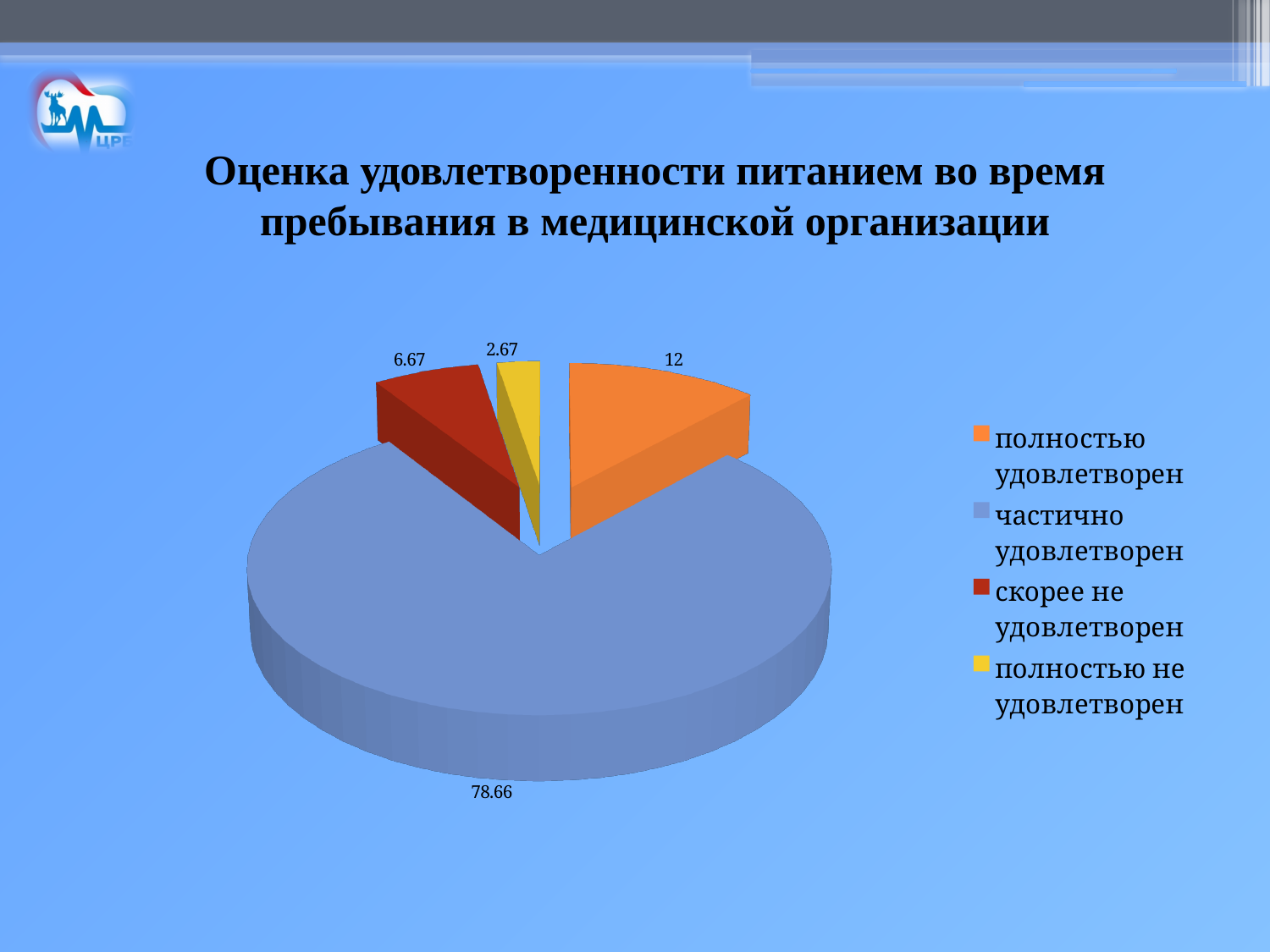
What is the value for "полностью удовлетворен"? 12 Which category has the largest slice? частично удовлетворен How many slices does the pie chart have? 4 What is the value for "полностью не удовлетворен"? 2.67 How many entries does the legend list? 4 What kind of chart is shown on the slide? pie chart What colour is the slice for "частично удовлетворен"? blue Which category has the smallest slice? полностью не удовлетворен What is the value for "частично удовлетворен"? 78.66 What is the value for "скорее не удовлетворен"? 6.67 What is the difference between the values for "полностью удовлетворен" and "скорее не удовлетворен"? 5.33 Which is larger, the value for "полностью удовлетворен" or the value for "полностью не удовлетворен"? полностью удовлетворен